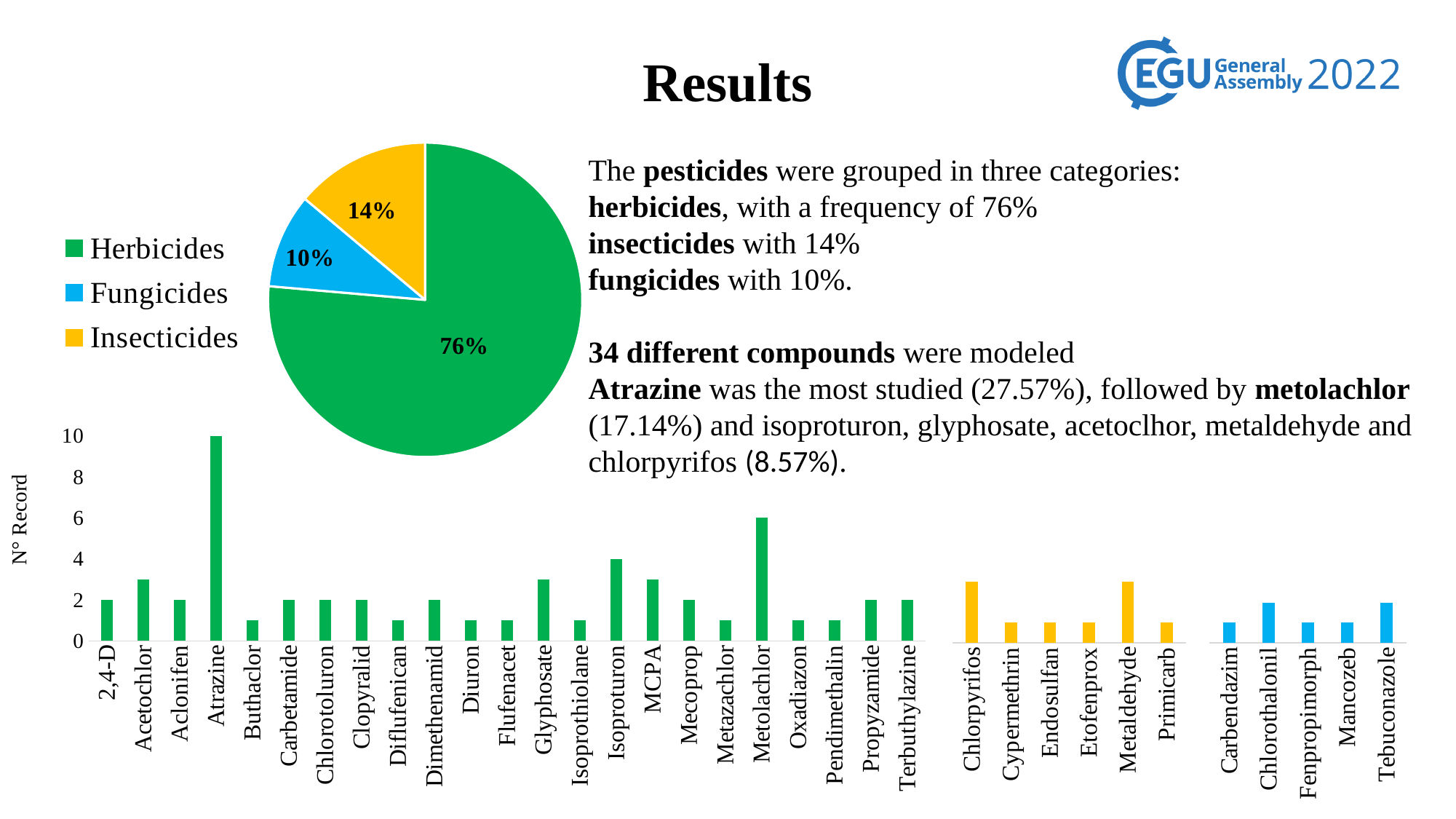
How many categories does the pie chart legend list? 3 In the pie chart, which category has the smallest slice? Fungicides In the bar chart at the bottom, what is the N° Record for Atrazine? 10 What kind of chart is the chart at the bottom of the slide showing N° Record? bar chart In the pie chart, what is the difference between the Insecticides share and the Fungicides share? 4% In the bar chart at the bottom, what is the N° Record for Metolachlor? 6 In the bar chart at the bottom, is the value for Chlorpyrifos greater or less than 2? greater In the bar chart at the bottom, which compound has the highest N° Record? Atrazine In the pie chart, what share do Herbicides have? 76% In the bar chart at the bottom, what is the difference in N° Record between Atrazine and Metolachlor? 4 How many compounds are shown on the x axis of the bar chart at the bottom? 34 In the pie chart, which category has the largest slice? Herbicides